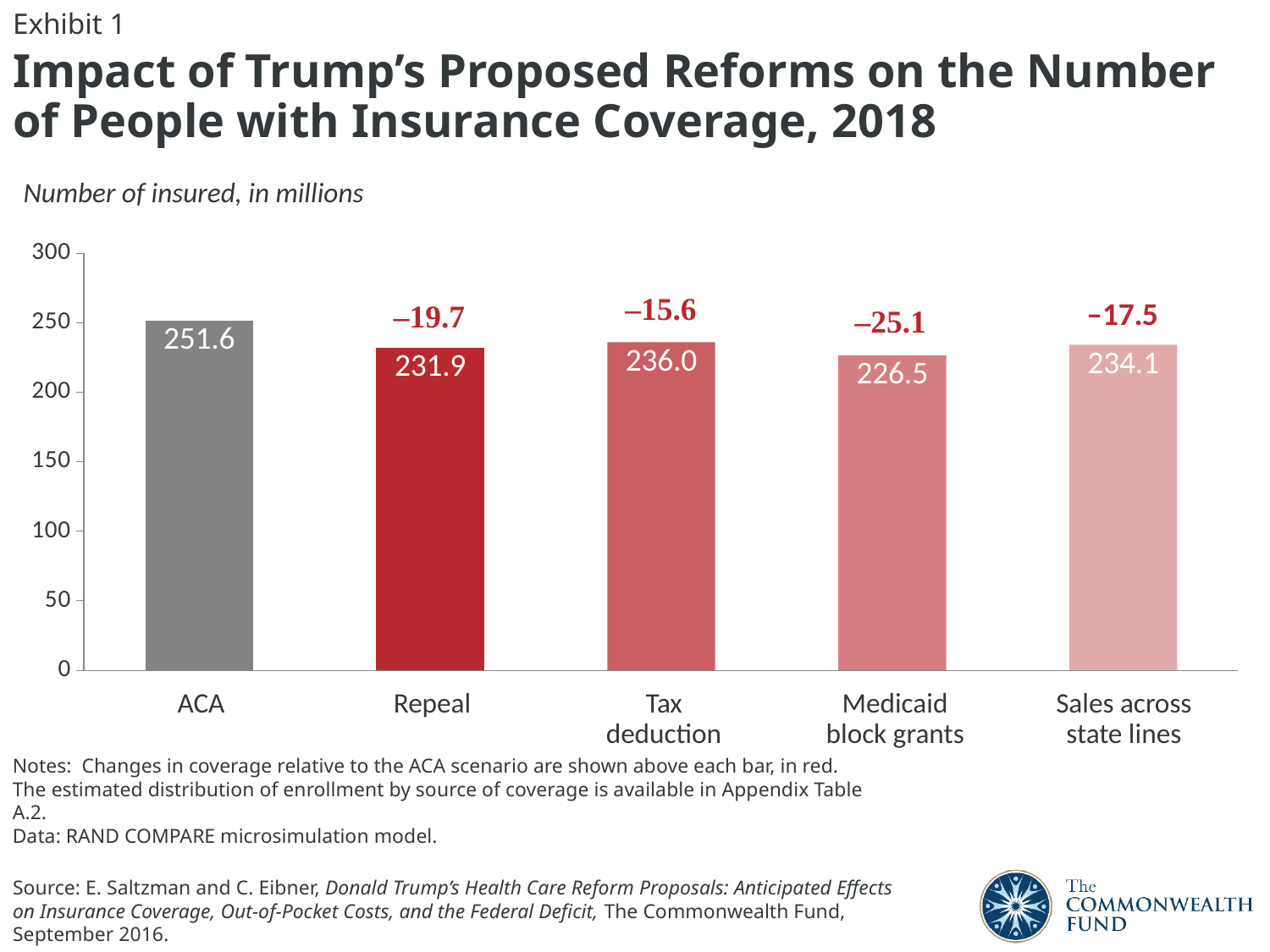
Which scenario has the lowest number of insured? Medicaid block grants What type of chart is shown on the slide? Bar chart What is the number of insured, in millions, under the Sales across state lines scenario? 234.1 What colour is the ACA bar? Gray What is the difference in millions of insured between the ACA and Tax deduction scenarios? 15.6 Is the value for Medicaid block grants greater or less than 250? less Which scenario has the highest number of insured? ACA What is the number of insured, in millions, under the Medicaid block grants scenario? 226.5 Which has more insured people, Repeal or Tax deduction? Tax deduction How many scenarios (bars) are shown in the chart? 5 What is the number of insured, in millions, under the ACA scenario? 251.6 What change in coverage relative to the ACA is shown above the Repeal bar? –19.7